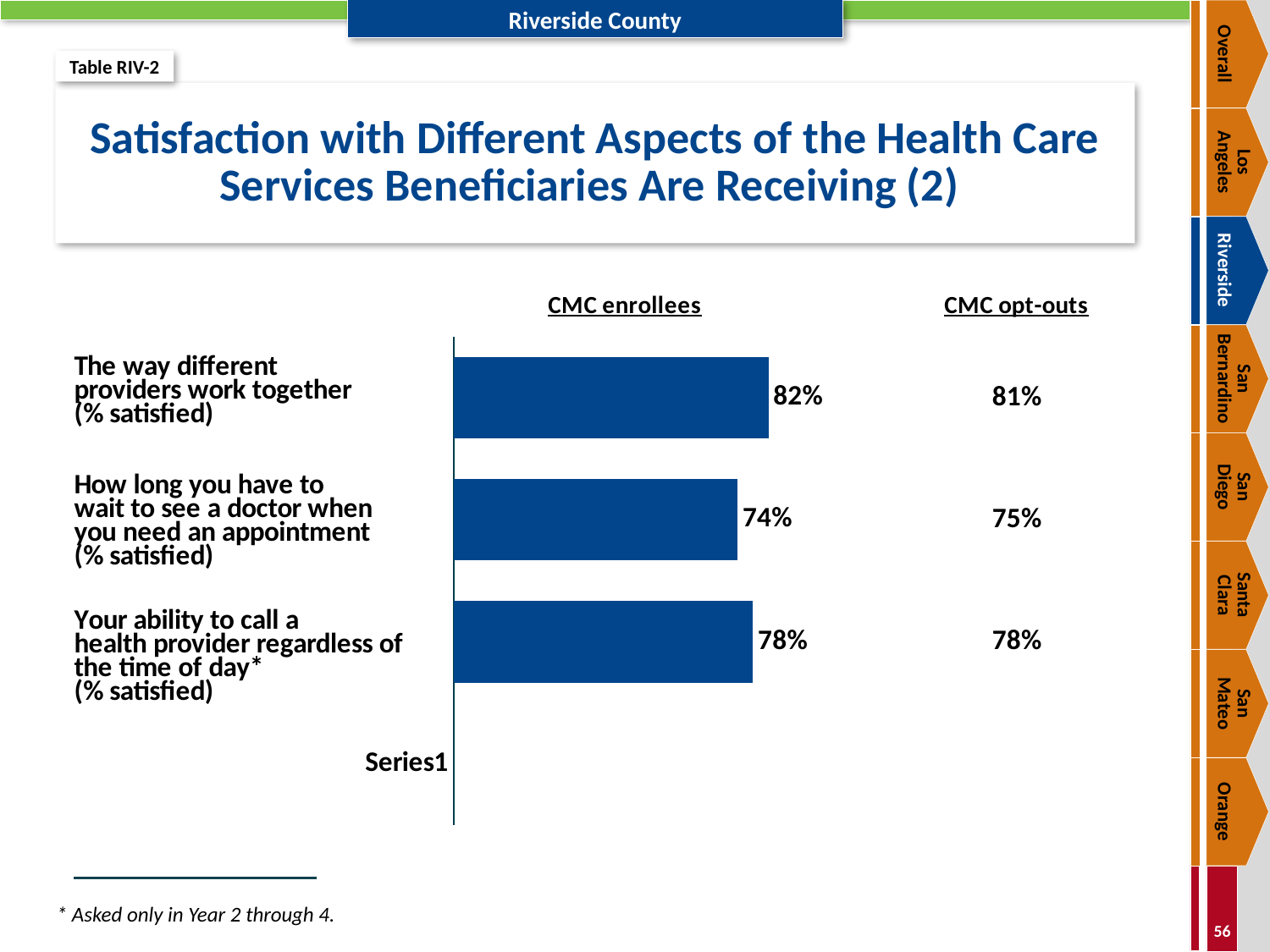
How many bars are plotted in the chart? 3 What is the title of the chart on the slide? Satisfaction with Different Aspects of the Health Care Services Beneficiaries Are Receiving (2) For 'How long you have to wait to see a doctor', which is larger: the CMC enrollees value or the CMC opt-outs value? CMC opt-outs What is the CMC enrollees value for 'Your ability to call a health provider regardless of the time of day (% satisfied)'? 78% What is the CMC opt-outs value for 'How long you have to wait to see a doctor when you need an appointment (% satisfied)'? 75% What is the CMC opt-outs value for 'The way different providers work together (% satisfied)'? 81% What is the CMC enrollees value for 'The way different providers work together (% satisfied)'? 82% What type of chart is shown on the slide? Bar chart What is the difference between the highest and lowest CMC enrollees values? 8 percentage points What is the difference between the CMC enrollees and CMC opt-outs values for 'The way different providers work together'? 1 percentage point Which aspect has the highest CMC enrollees satisfaction? The way different providers work together Which aspect has the lowest CMC enrollees satisfaction? How long you have to wait to see a doctor when you need an appointment